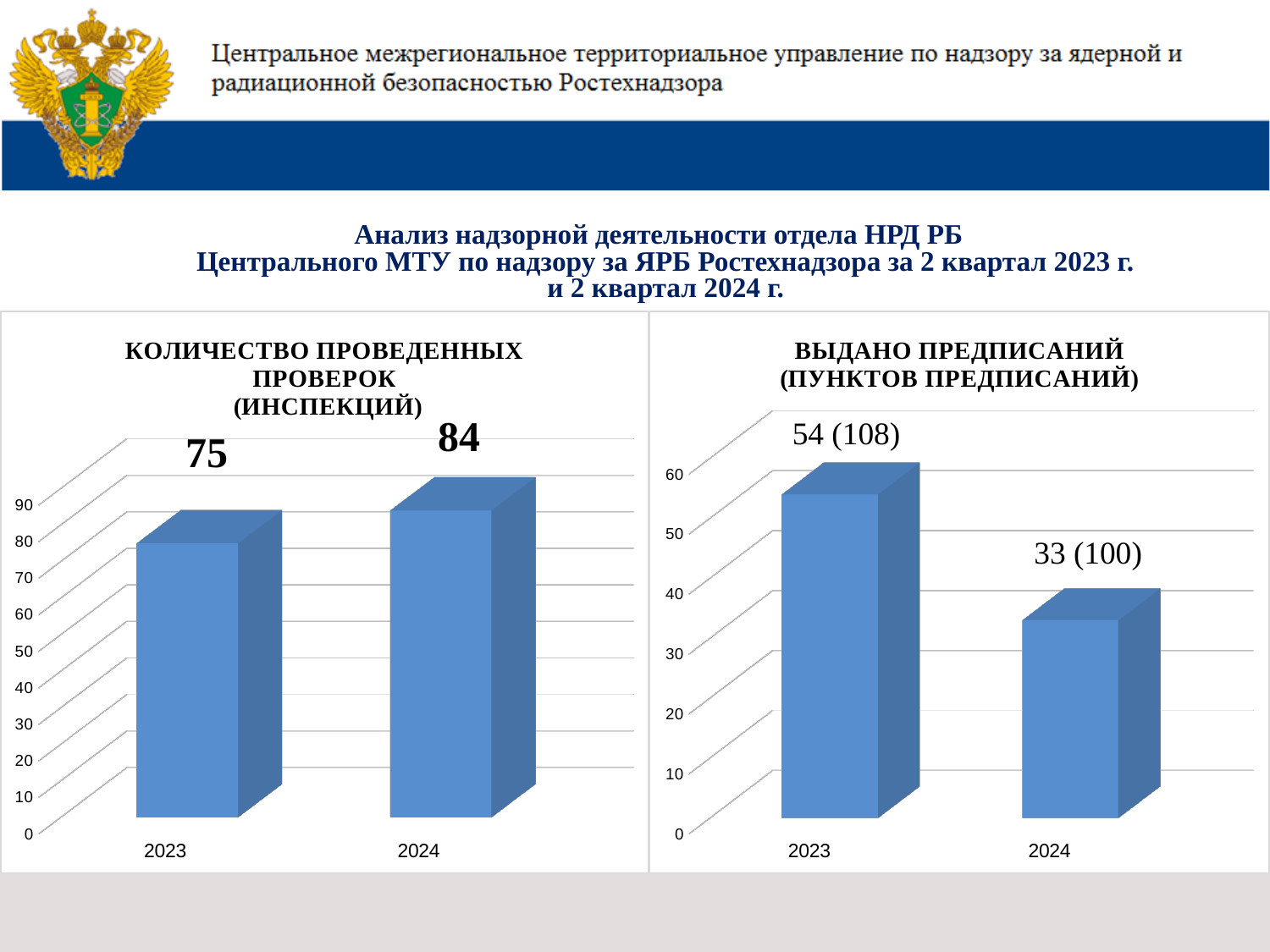
In the right chart 'ВЫДАНО ПРЕДПИСАНИЙ (ПУНКТОВ ПРЕДПИСАНИЙ)', what is the data label for 2024? 33 (100) In the right chart 'ВЫДАНО ПРЕДПИСАНИЙ (ПУНКТОВ ПРЕДПИСАНИЙ)', which year has the lower value? 2024 In the left chart 'КОЛИЧЕСТВО ПРОВЕДЕННЫХ ПРОВЕРОК (ИНСПЕКЦИЙ)', what is the value for 2023? 75 How many categories are shown on the x axis of the left chart 'КОЛИЧЕСТВО ПРОВЕДЕННЫХ ПРОВЕРОК (ИНСПЕКЦИЙ)'? 2 In the left chart 'КОЛИЧЕСТВО ПРОВЕДЕННЫХ ПРОВЕРОК (ИНСПЕКЦИЙ)', what is the value for 2024? 84 In the right chart 'ВЫДАНО ПРЕДПИСАНИЙ (ПУНКТОВ ПРЕДПИСАНИЙ)', is the value for 2024 greater or less than 40? less In the left chart 'КОЛИЧЕСТВО ПРОВЕДЕННЫХ ПРОВЕРОК (ИНСПЕКЦИЙ)', do the values rise or fall from 2023 to 2024? rise In the right chart 'ВЫДАНО ПРЕДПИСАНИЙ (ПУНКТОВ ПРЕДПИСАНИЙ)', do the values rise or fall from 2023 to 2024? fall What kind of chart is the right chart 'ВЫДАНО ПРЕДПИСАНИЙ (ПУНКТОВ ПРЕДПИСАНИЙ)'? bar chart In the left chart 'КОЛИЧЕСТВО ПРОВЕДЕННЫХ ПРОВЕРОК (ИНСПЕКЦИЙ)', what is the difference between the 2024 and 2023 values? 9 In the left chart 'КОЛИЧЕСТВО ПРОВЕДЕННЫХ ПРОВЕРОК (ИНСПЕКЦИЙ)', which year has the higher value? 2024 In the right chart 'ВЫДАНО ПРЕДПИСАНИЙ (ПУНКТОВ ПРЕДПИСАНИЙ)', what is the data label for 2023? 54 (108)